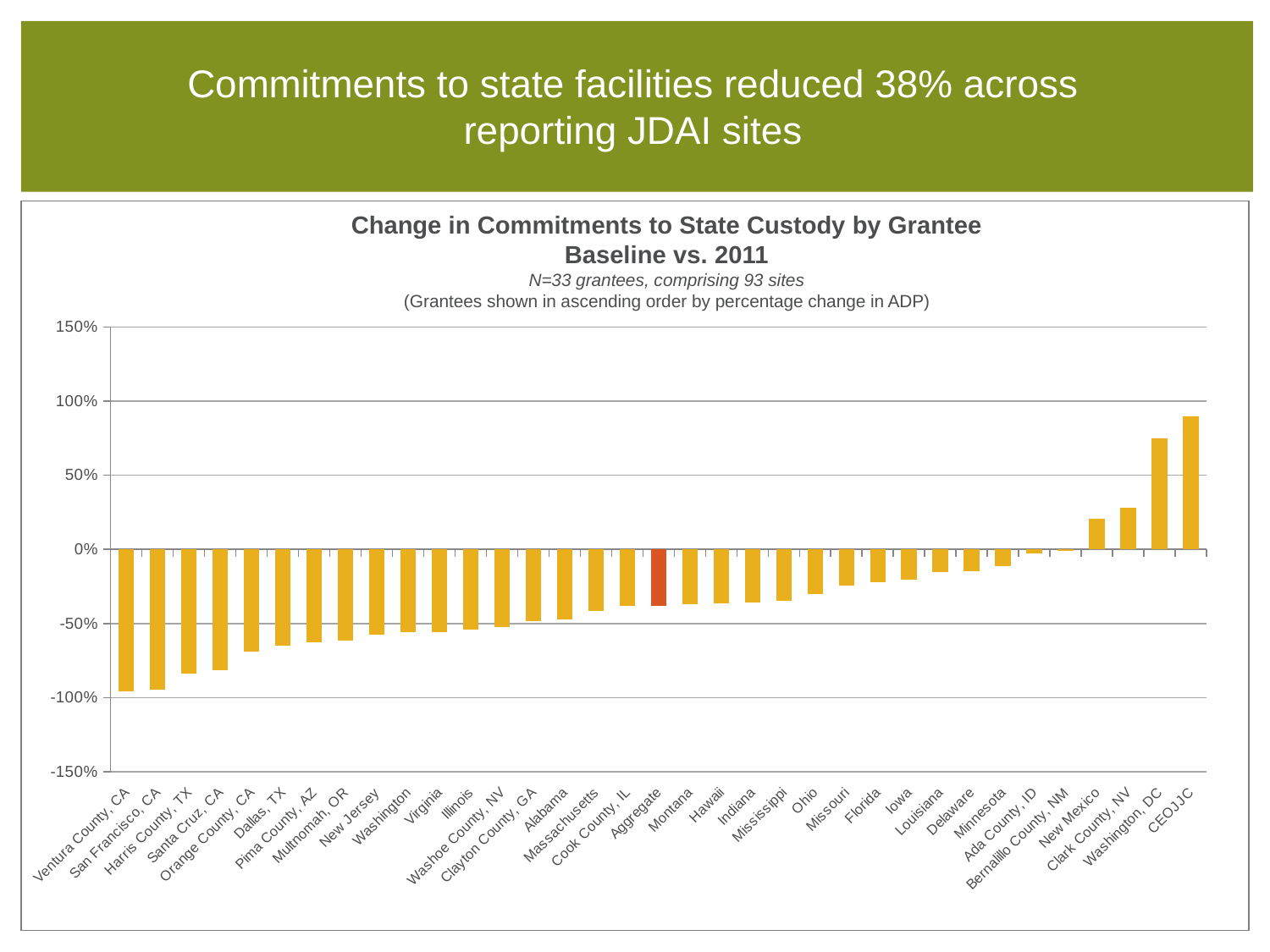
Which has the larger value, Washington, DC or New Mexico? Washington, DC Which bar is shown in a different colour (orange) from the others? Aggregate Which grantee has the highest percentage change in commitments to state custody? CEOJJC Which has the larger value, Ventura County, CA or Ohio? Ohio Is the value for Harris County, TX greater or less than -50%? less Do the values rise or fall moving from left to right along the x axis? rise Is the value for Clark County, NV greater or less than 50%? less Is the value for Aggregate greater or less than -50%? greater What kind of chart is shown on the slide? bar chart